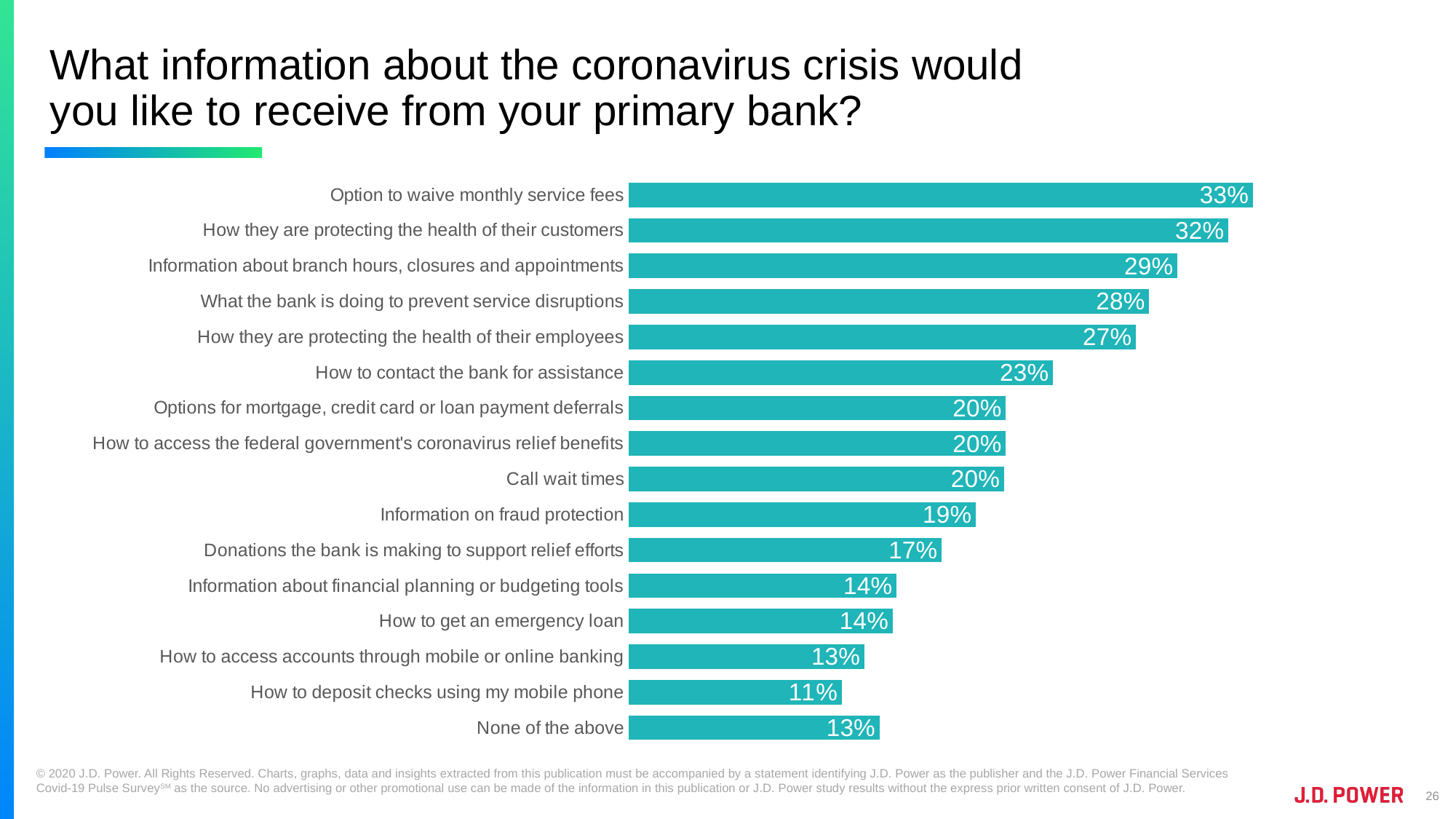
What percentage selected "How to deposit checks using my mobile phone"? 11% How many categories have a value of exactly 20%? 3 Which is larger: "Information on fraud protection" or "Donations the bank is making to support relief efforts"? Information on fraud protection What is the value for "None of the above"? 13% What is the value for "How to contact the bank for assistance"? 23% Which category has the lowest value? How to deposit checks using my mobile phone What kind of chart is shown on the slide? Bar chart What is the difference between "Option to waive monthly service fees" and "How they are protecting the health of their employees"? 6% How many categories are shown in the chart? 16 What colour are the bars in the chart? Teal What percentage of respondents would like to receive information about the option to waive monthly service fees? 33% Which category has the highest value? Option to waive monthly service fees